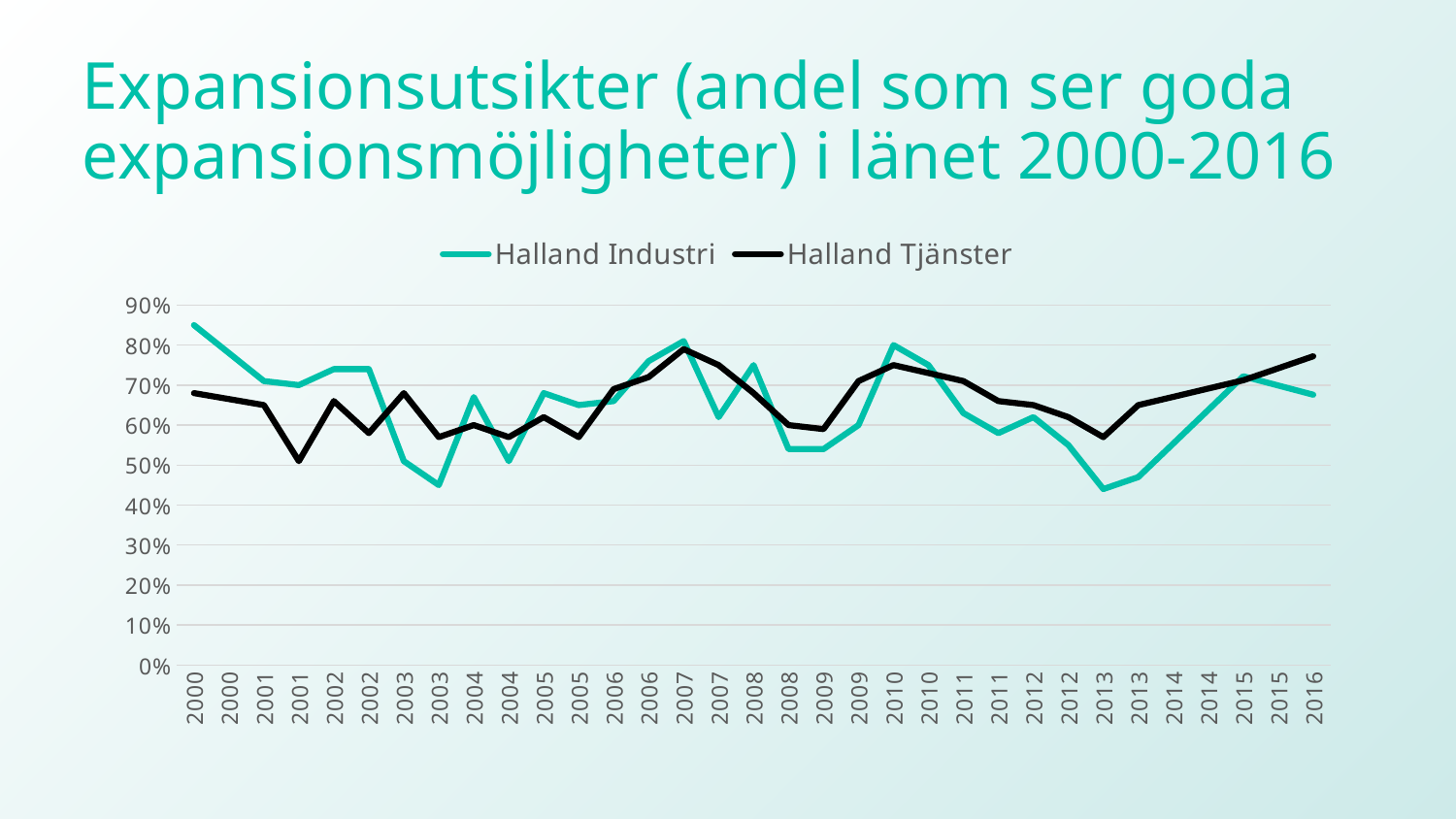
Does the Halland Tjänster line rise or fall from the first 2013 point to 2016? rise Is the value for Halland Industri at the first 2000 point greater or less than 80%? greater At the first 2013 point, which series has the higher value, Halland Industri or Halland Tjänster? Halland Tjänster Is the value for Halland Industri at the second 2003 point greater or less than 50%? less How many data points are plotted along the x axis for each series? 33 What are the two series named in the legend? Halland Industri and Halland Tjänster What kind of chart is shown on the slide? line chart How many series does the legend list? 2 At the first 2000 point, which series has the higher value, Halland Industri or Halland Tjänster? Halland Industri Is the value for Halland Tjänster at 2016 greater or less than 70%? greater At which x-axis point does Halland Tjänster reach its lowest value? the second 2001 point